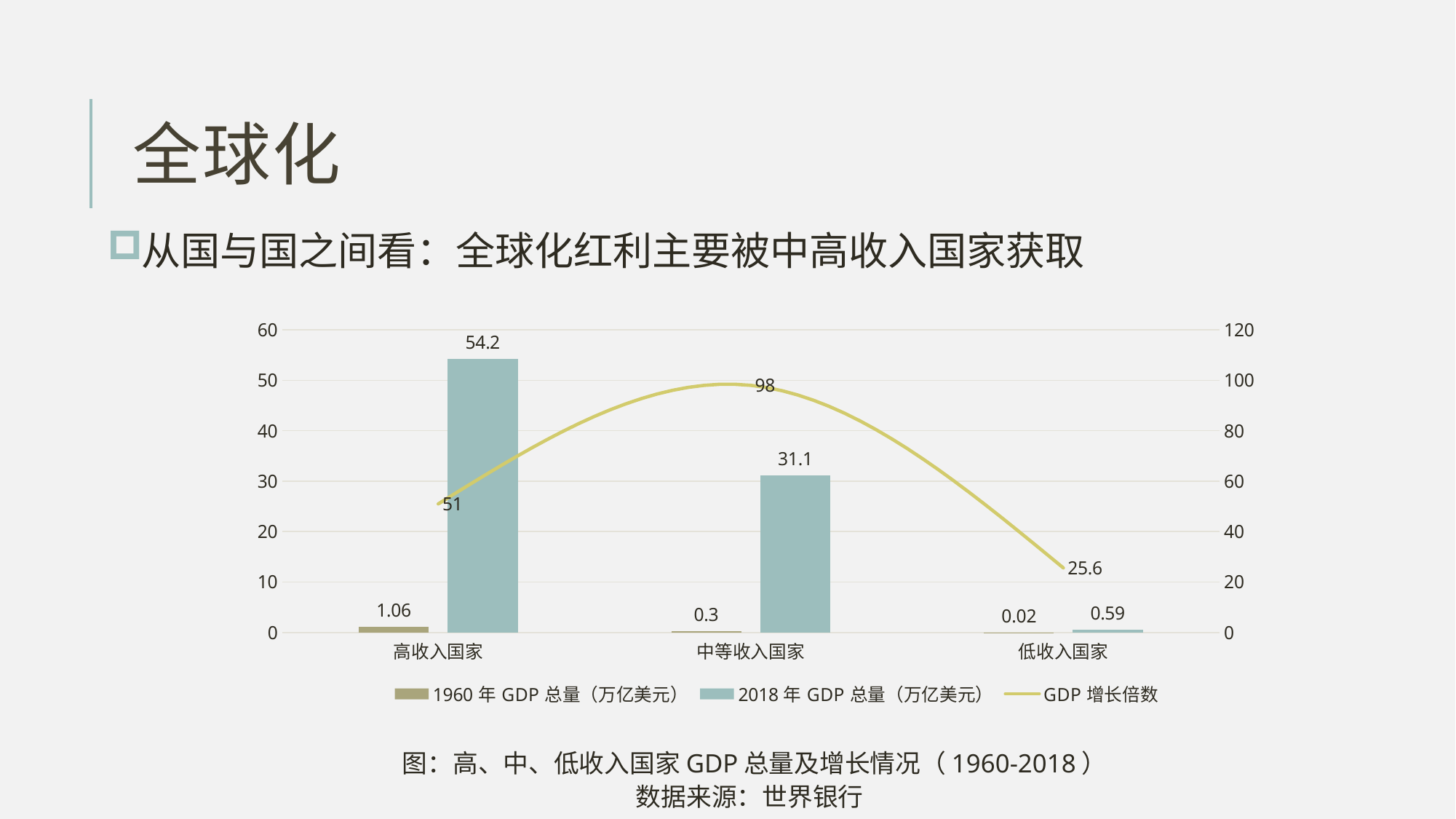
How many categories are shown on the x axis? 3 What is the 1960 年 GDP 总量 value for 中等收入国家? 0.3 What is the GDP 增长倍数 value for 低收入国家? 25.6 What is the 2018 年 GDP 总量 value for 高收入国家? 54.2 How many series does the legend list? 3 Which category has the lowest 2018 年 GDP 总量? 低收入国家 Which is larger: the GDP 增长倍数 for 高收入国家 or for 低收入国家? 高收入国家 What kind of chart is this? Combination bar and line chart Which category has the highest GDP 增长倍数? 中等收入国家 What is the difference between the 2018 年 GDP 总量 of 高收入国家 and 中等收入国家? 23.1 What is the data source stated below the chart? 世界银行 Is the 2018 年 GDP 总量 for 中等收入国家 greater or less than 30? greater